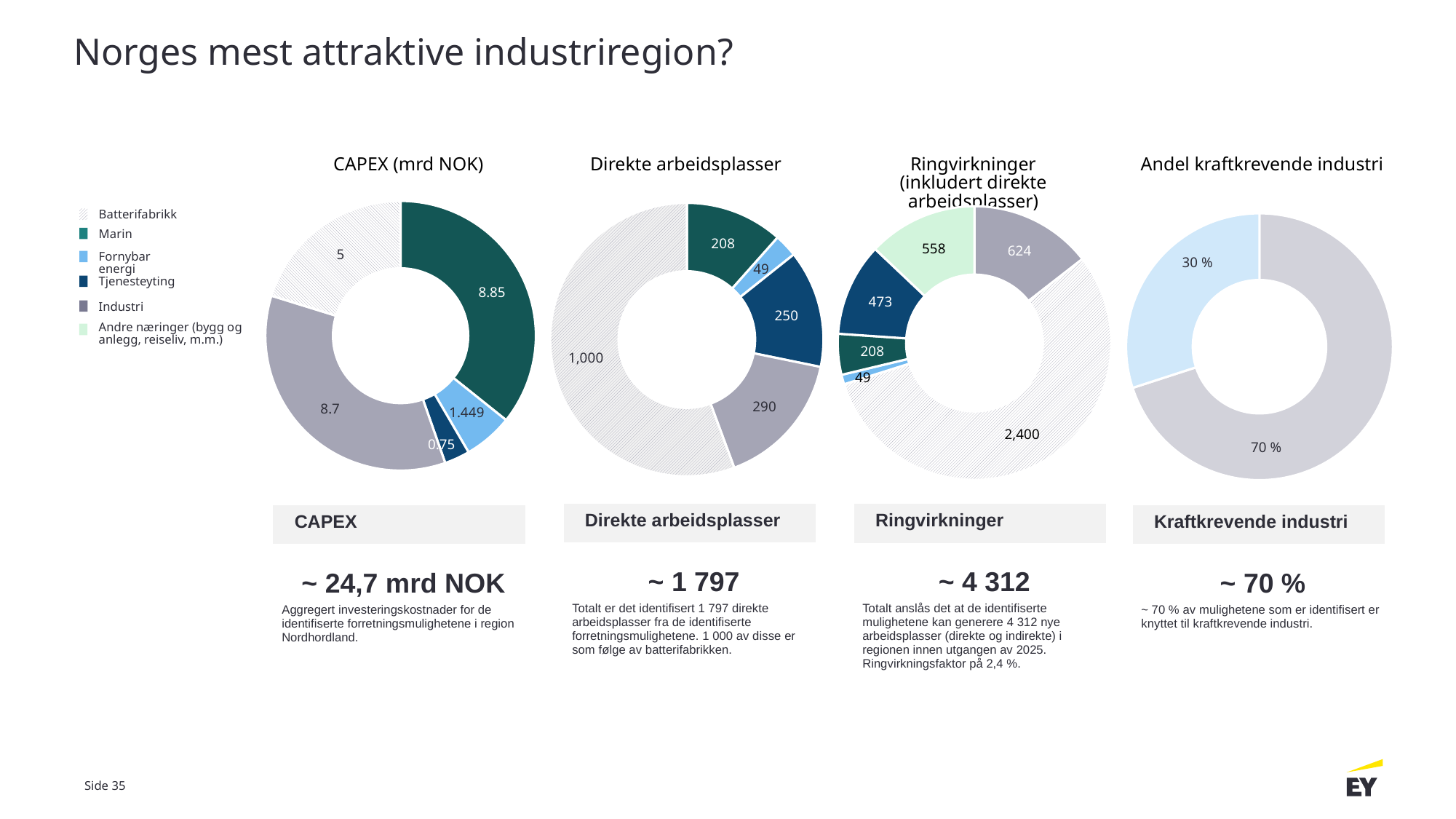
In the CAPEX (mrd NOK) chart, what is the value for Marin? 8.85 In the CAPEX (mrd NOK) chart, which category has the lowest value? Tjenesteyting What kind of chart is the CAPEX (mrd NOK) chart? Donut chart In the Direkte arbeidsplasser chart, what is the difference between Industri and Tjenesteyting? 40 How many slices does the Ringvirkninger chart have? 6 In the Ringvirkninger chart, what is the value for Tjenesteyting? 473 In the Andel kraftkrevende industri chart, what share is shown for the larger slice? 70 % In the Ringvirkninger chart, which is larger, Industri or Andre næringer? Industri In the Direkte arbeidsplasser chart, which category has the highest value? Batterifabrikk In the Ringvirkninger chart, what is the difference between Batterifabrikk and Industri? 1,776 In the CAPEX (mrd NOK) chart, what is the value for Tjenesteyting? 0.75 In the Direkte arbeidsplasser chart, what is the value for Batterifabrikk? 1,000